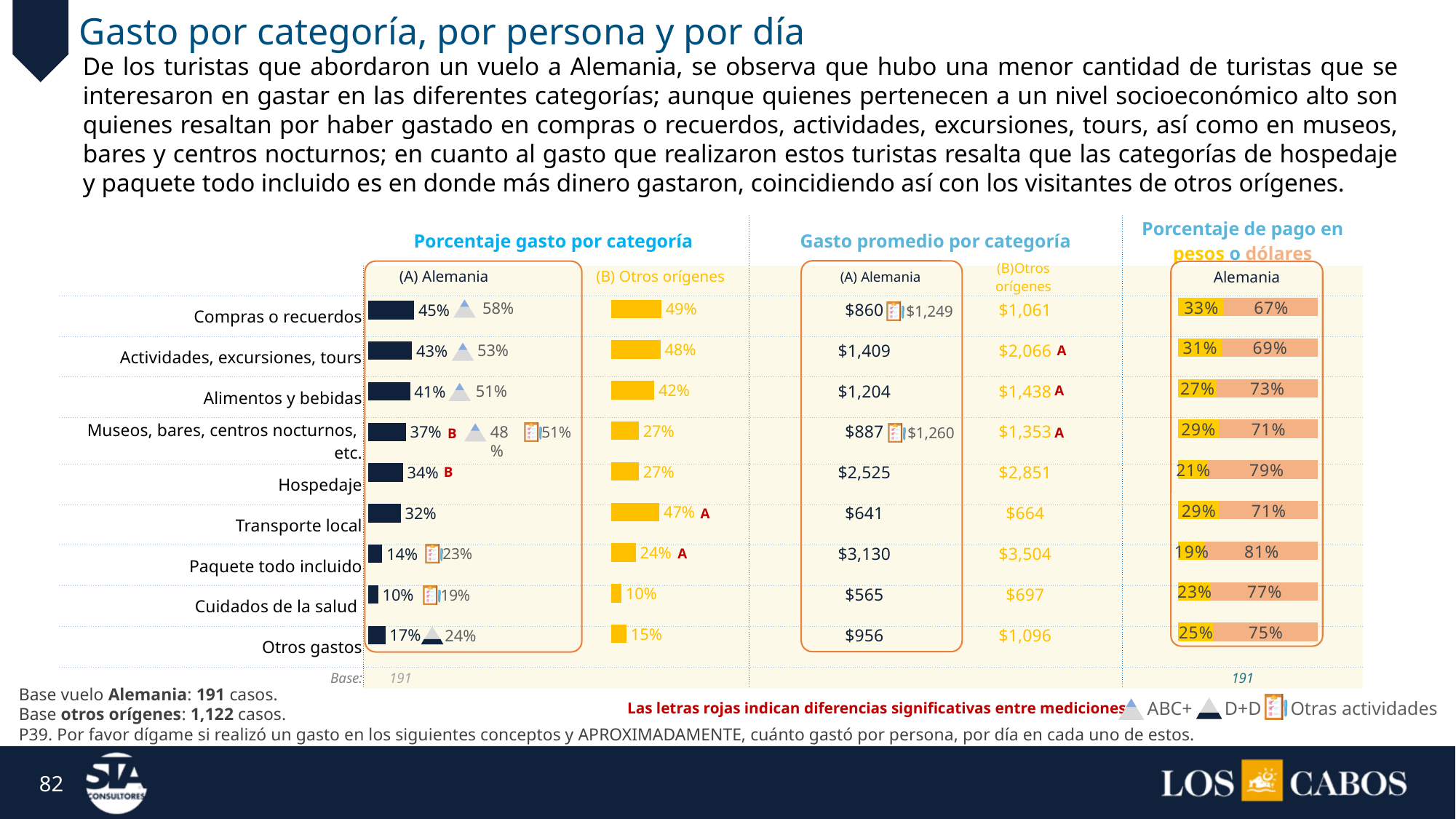
In the 'Porcentaje de pago en pesos o dólares' chart, what percentage of Hospedaje payments by Alemania tourists were in pesos? 21% How many spending categories are listed in the 'Porcentaje gasto por categoría' chart? 9 In the 'Porcentaje gasto por categoría' chart, what is the difference between (B) Otros orígenes and (A) Alemania for Compras o recuerdos? 4 percentage points In the 'Gasto promedio por categoría' chart, which category has the lowest average spend for (A) Alemania? Cuidados de la salud In the 'Gasto promedio por categoría' chart, what is the difference between (B) Otros orígenes and (A) Alemania for Hospedaje? $326 In the 'Porcentaje gasto por categoría' chart, for Transporte local, which is larger: (A) Alemania or (B) Otros orígenes? (B) Otros orígenes In the 'Gasto promedio por categoría' chart, which category has the highest average spend for (B) Otros orígenes? Paquete todo incluido In the 'Porcentaje gasto por categoría' chart, which category has the highest percentage for (A) Alemania? Compras o recuerdos In the 'Gasto promedio por categoría' chart, what is the average spend for (A) Alemania on Paquete todo incluido? $3,130 In the 'Porcentaje gasto por categoría' chart, what is the value for (B) Otros orígenes in Transporte local? 47% In the 'Porcentaje gasto por categoría' chart, which category has the lowest percentage for (A) Alemania? Cuidados de la salud In the 'Porcentaje gasto por categoría' chart, what percentage of Alemania tourists spent on Hospedaje? 34%